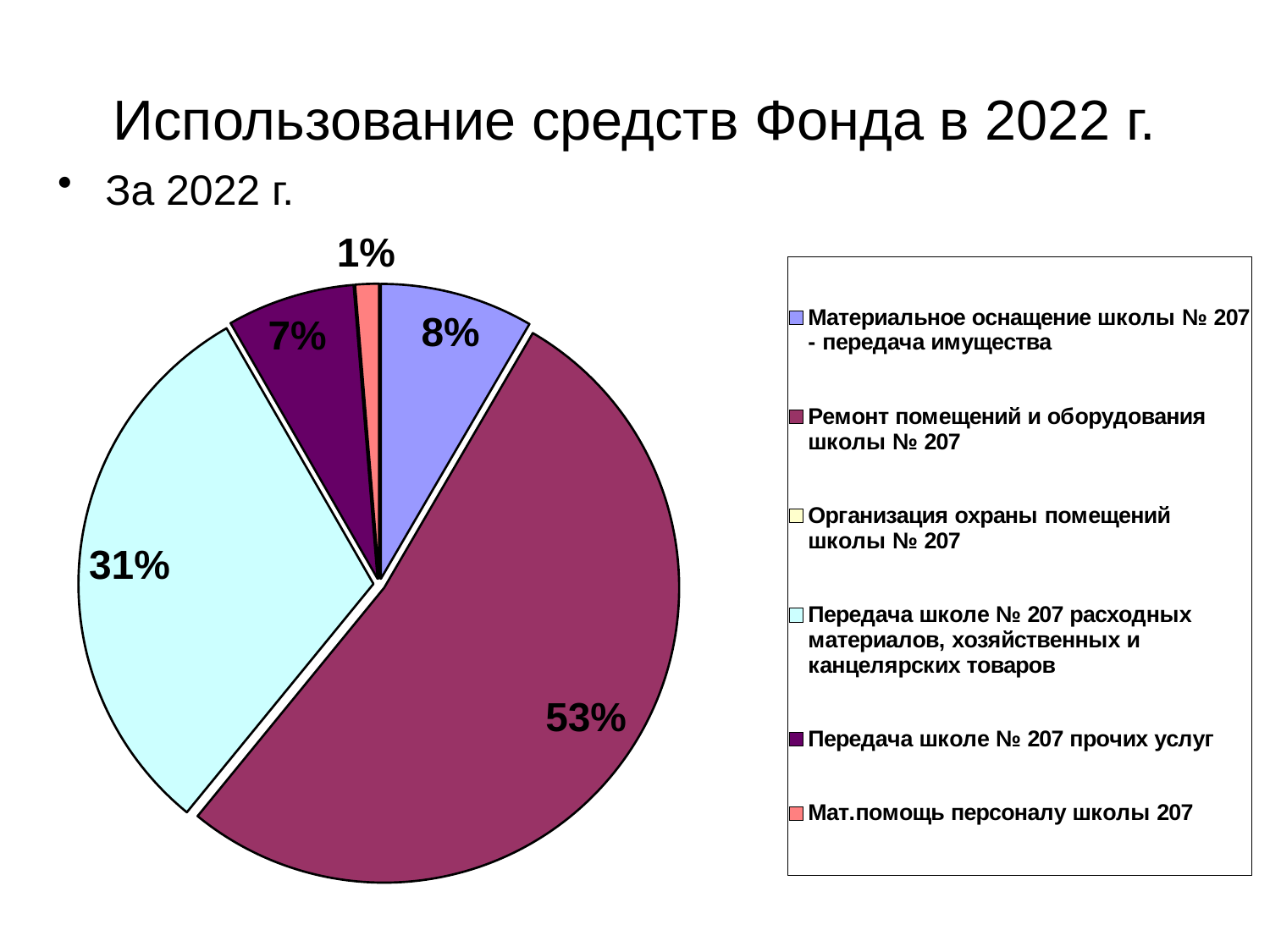
Which labelled slice of the pie is the smallest? Мат.помощь персоналу школы 207 Which category has the largest slice of the pie? Ремонт помещений и оборудования школы № 207 What share of the pie is labelled for "Передача школе № 207 прочих услуг"? 7% What share of the pie is labelled for "Мат.помощь персоналу школы 207"? 1% What is the difference in percentage points between the slice for "Ремонт помещений и оборудования школы № 207" and the slice for "Передача школе № 207 расходных материалов, хозяйственных и канцелярских товаров"? 22% Which is larger: the slice for "Материальное оснащение школы № 207 - передача имущества" or the slice for "Передача школе № 207 прочих услуг"? Материальное оснащение школы № 207 - передача имущества What share of the pie is labelled for "Материальное оснащение школы № 207 - передача имущества"? 8% What is the title of the slide containing the pie chart? Использование средств Фонда в 2022 г. What kind of chart is shown on the slide? pie chart How many entries does the legend of the pie chart list? 6